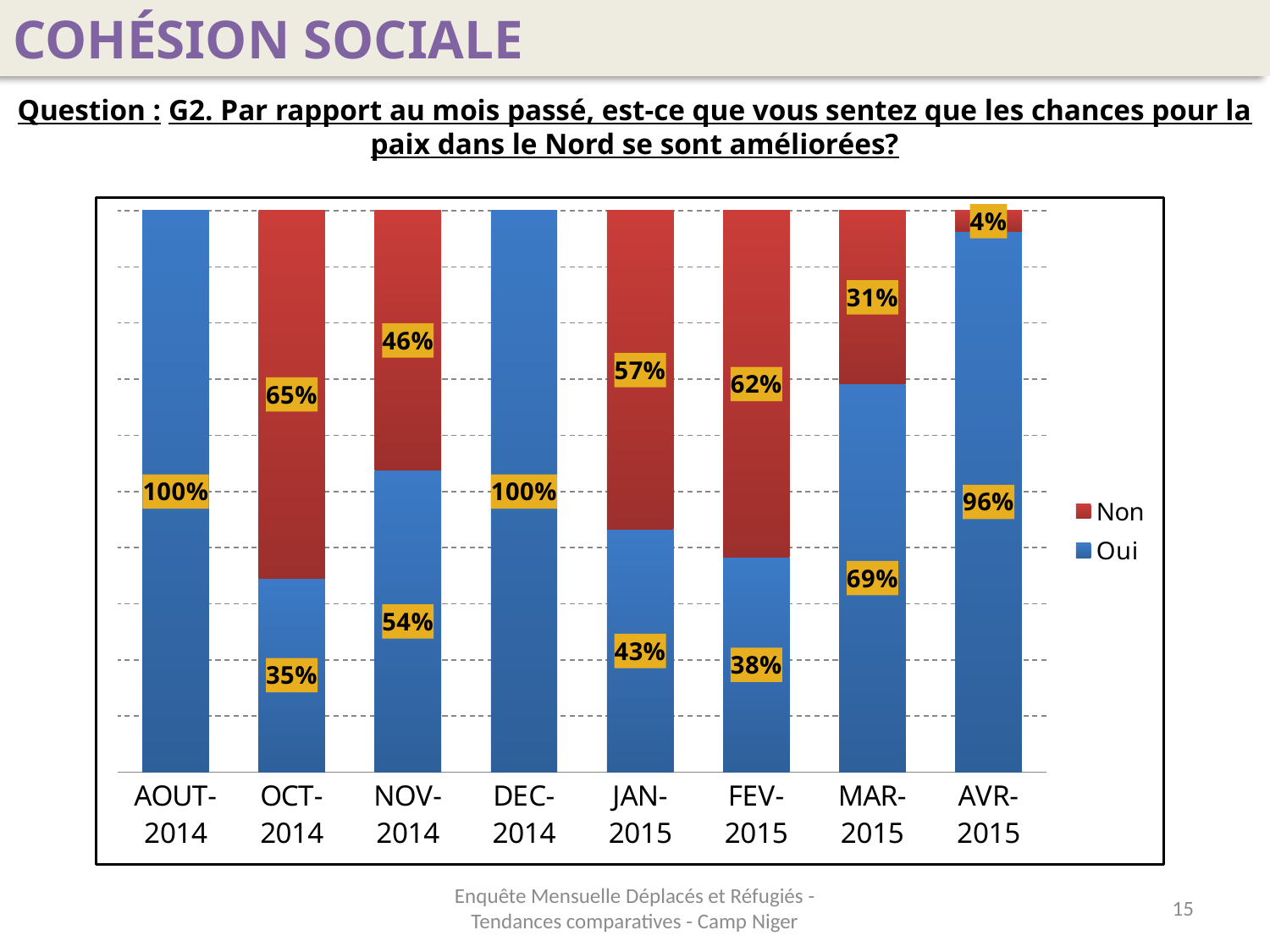
What kind of chart is shown on the slide? stacked bar chart What is the value of the Non series for MAR-2015? 31% What is the difference between the Non value for JAN-2015 and the Non value for NOV-2014? 11% Which month has the highest Non value? OCT-2014 What is the value of the Oui series for OCT-2014? 35% How many series does the legend list? 2 Which colour represents the Non series in the chart? red Which is larger: the Oui value for NOV-2014 or the Oui value for JAN-2015? NOV-2014 What is the value of the Oui series for AVR-2015? 96% What is the value of the Non series for FEV-2015? 62% How many months are shown on the x axis? 8 Among the months where a Non value is shown, which has the lowest Non value? AVR-2015